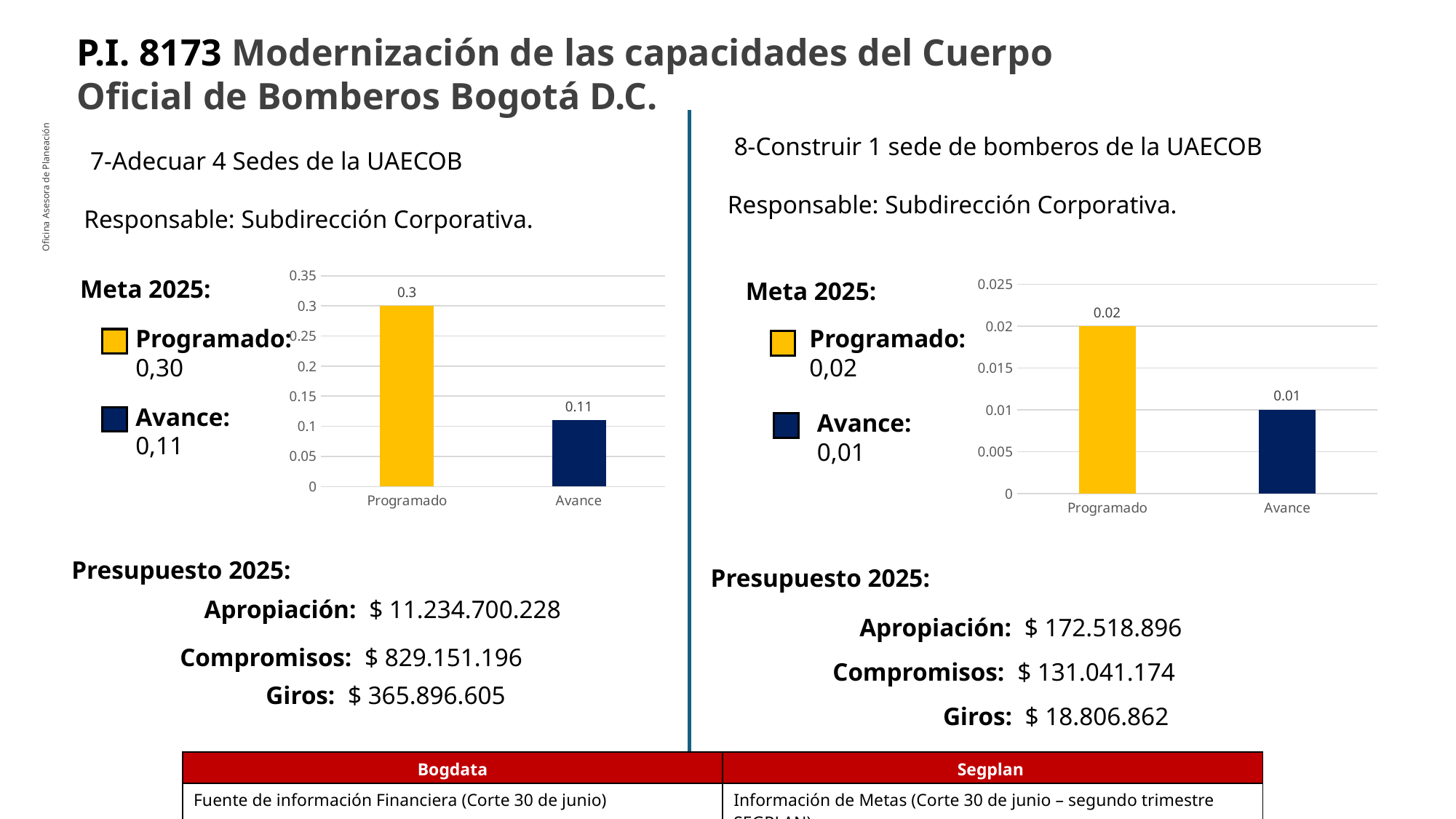
In the left chart (7-Adecuar 4 Sedes de la UAECOB), what is the value of the Avance bar? 0.11 How many bars are plotted in the left chart? 2 In the right chart (8-Construir 1 sede de bomberos de la UAECOB), what is the value of the Avance bar? 0.01 In the left chart, is the Avance value greater or less than 0.15? less In the left chart, which bar is higher, Programado or Avance? Programado In the right chart (8-Construir 1 sede de bomberos de la UAECOB), what is the value of the Programado bar? 0.02 In the left chart, what is the difference between the Programado and Avance values? 0.19 What colour is the Programado bar in the right chart? Yellow In the right chart, which category has the lowest value? Avance What type of chart is shown on the right side of the slide? Bar chart In the left chart (7-Adecuar 4 Sedes de la UAECOB), what is the value of the Programado bar? 0.3 In the right chart, what is the difference between the Programado and Avance values? 0.01